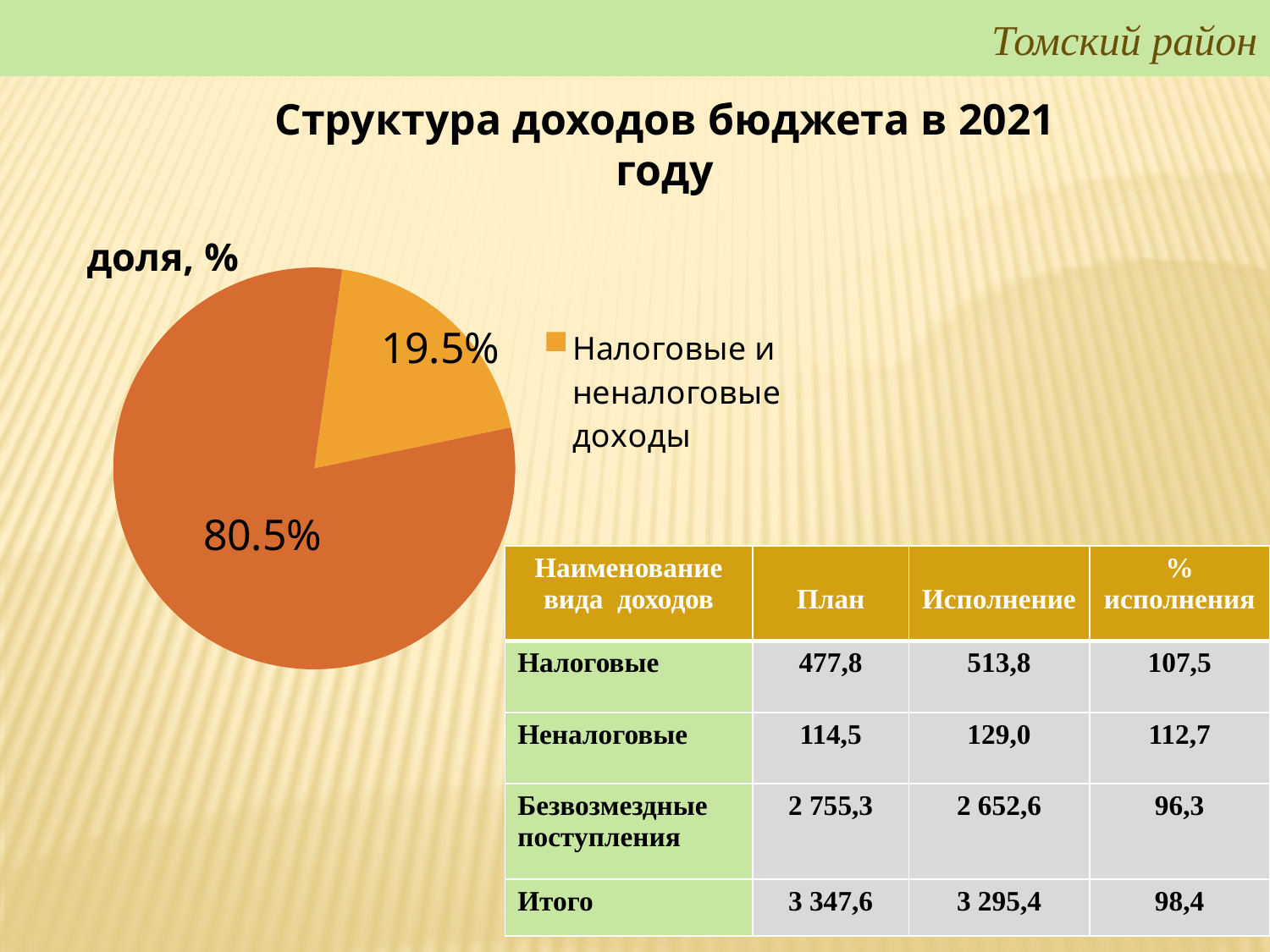
What is the value shown on the largest slice of the pie chart? 80.5% What share does the slice for "Налоговые и неналоговые доходы" have in the pie chart? 19.5% How many slices does the pie chart have? 2 Is the slice for "Налоговые и неналоговые доходы" the larger or the smaller slice of the pie chart? Smaller Is the share for "Налоговые и неналоговые доходы" greater or less than 50%? less What is the title of the pie chart? доля, % What is the smallest value shown on the pie chart? 19.5% What kind of chart is shown on the slide? Pie chart What do the two slice values of the pie chart add up to? 100% What is the difference between the two slice values in the pie chart (80.5% and 19.5%)? 61%